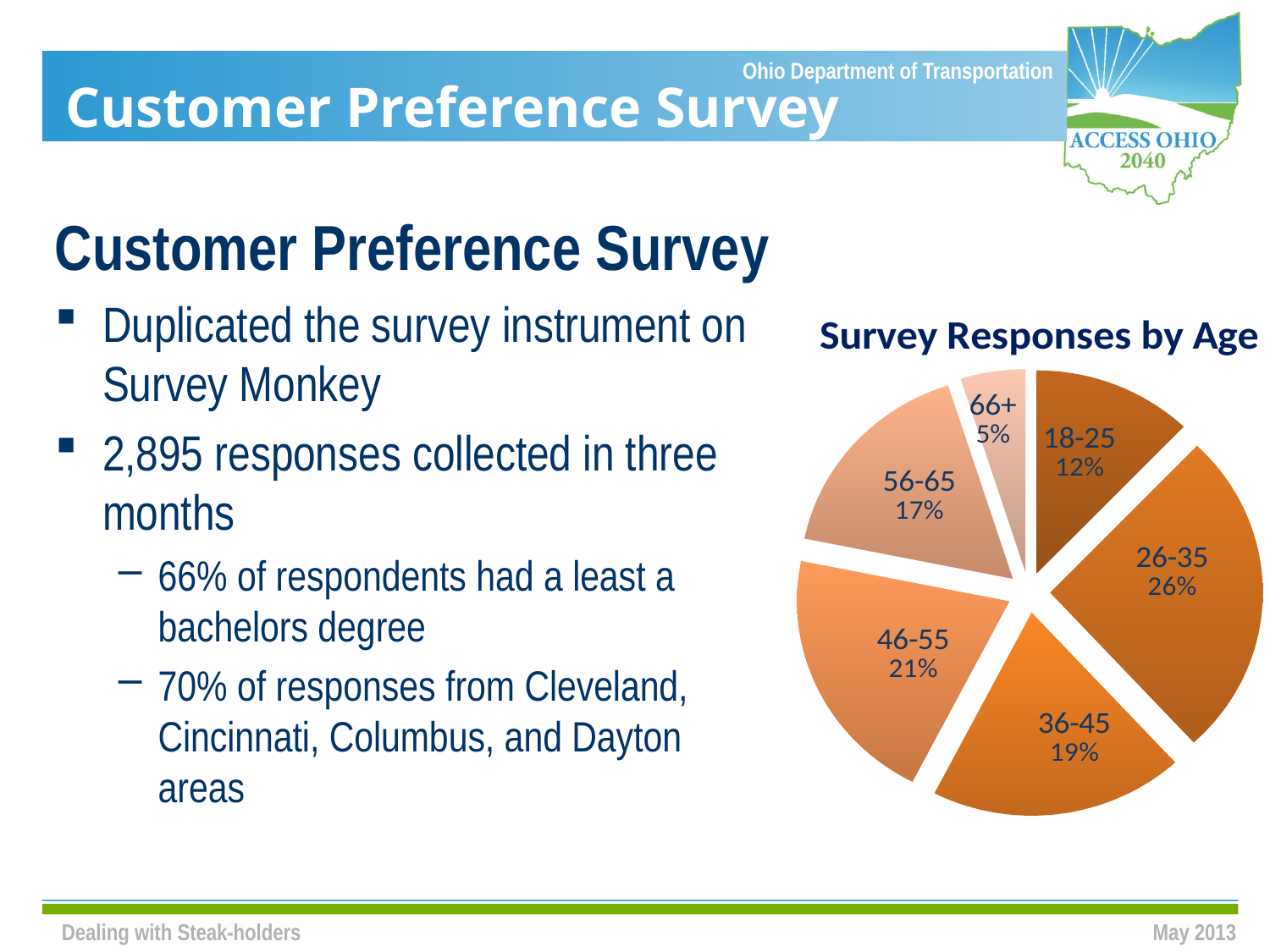
What type of chart is shown on the slide? pie chart What share of survey responses came from the 46-55 age group? 21% Which age group has a larger share of responses, 56-65 or 46-55? 46-55 Which age group has the smallest share of survey responses? 66+ What share of survey responses came from the 18-25 age group? 12% What share of survey responses came from the 66+ age group? 5% What is the title of the chart? Survey Responses by Age What share of survey responses came from the 26-35 age group? 26% What is the difference in percentage points between the 26-35 and 36-45 age groups? 7 Which age group has the largest share of survey responses? 26-35 What is the combined share of the 56-65 and 66+ age groups? 22% How many age groups are shown in the pie chart? 6